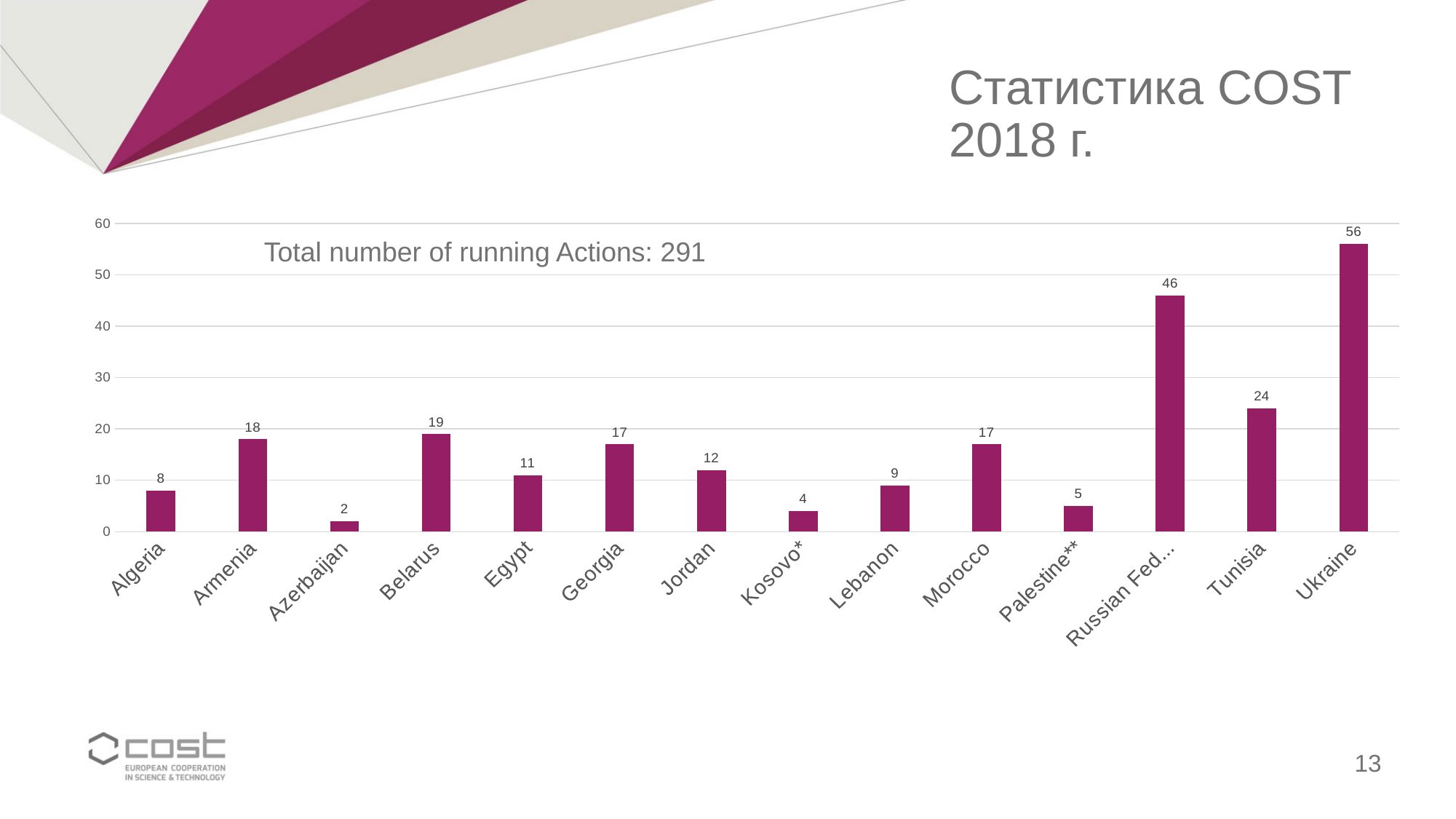
What kind of chart is shown on the slide? bar chart What is the value for Belarus? 19 Which country has the highest value? Ukraine What is the value for Tunisia? 24 Is the value for Russian Fed... greater or less than 40? greater What is the value for Kosovo*? 4 How many countries are shown on the x axis? 14 Which is larger, the value for Egypt or the value for Jordan? Jordan What total number of running Actions is stated on the chart? 291 What is the difference between the values for Ukraine and Russian Fed...? 10 Which country has the lowest value? Azerbaijan What is the difference between the values for Armenia and Algeria? 10